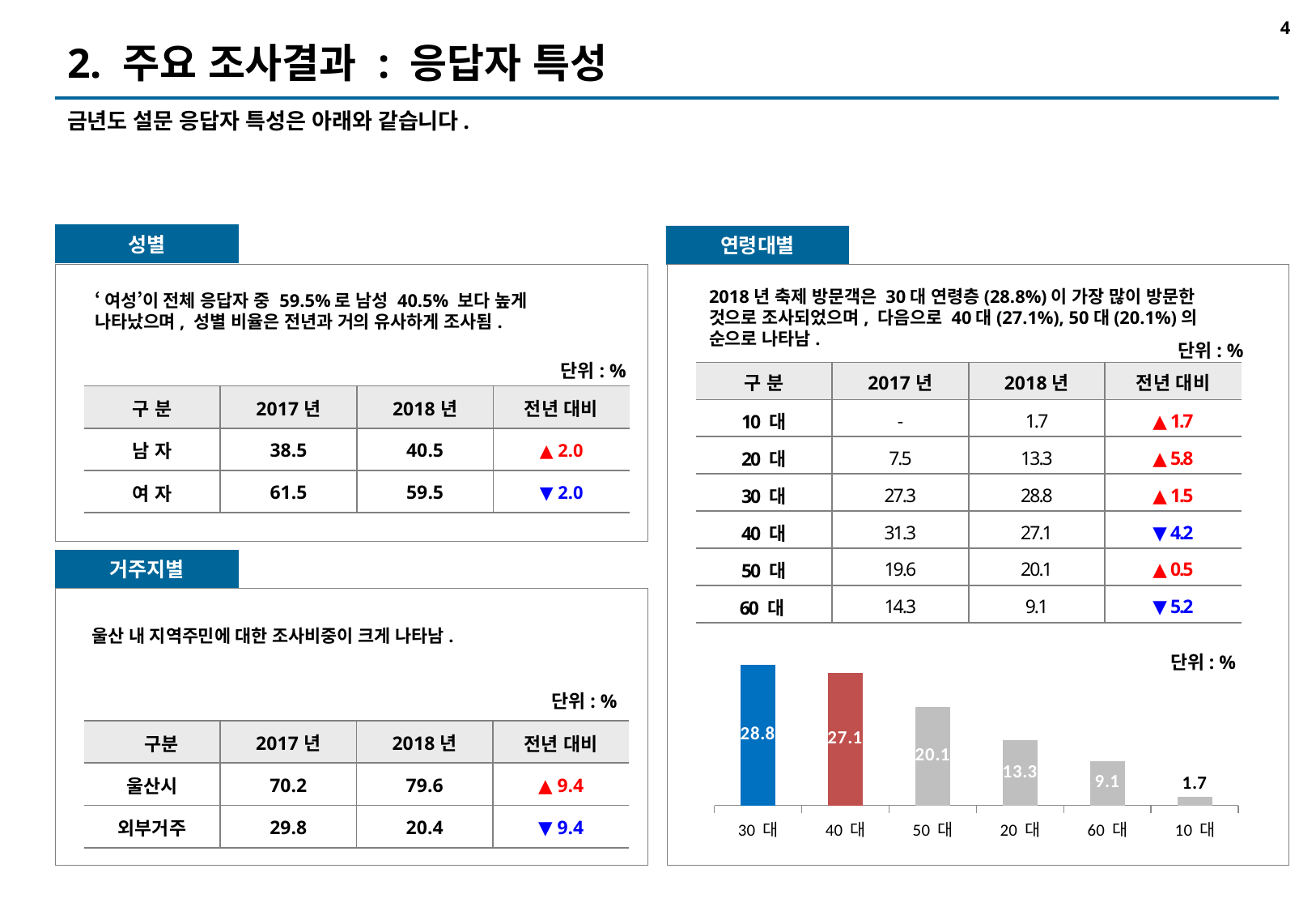
In the bar chart, what is the value for 10 대? 1.7 Which age group has the highest bar in the chart? 30 대 Which age group has the lowest bar in the chart? 10 대 In the bar chart, what is the difference between the values for 50 대 and 20 대? 6.8 In the bar chart, what is the value for 50 대? 20.1 How many age-group bars are plotted in the chart? 6 What kind of chart is shown in the 연령대별 section of the slide? bar chart In the bar chart, what is the value for 60 대? 9.1 In the bar chart, what is the value for 30 대? 28.8 In the bar chart, which is larger, the value for 20 대 or the value for 60 대? 20 대 In the bar chart, which age group's bar is coloured red? 40 대 In the bar chart, what is the difference between the values for 30 대 and 40 대? 1.7